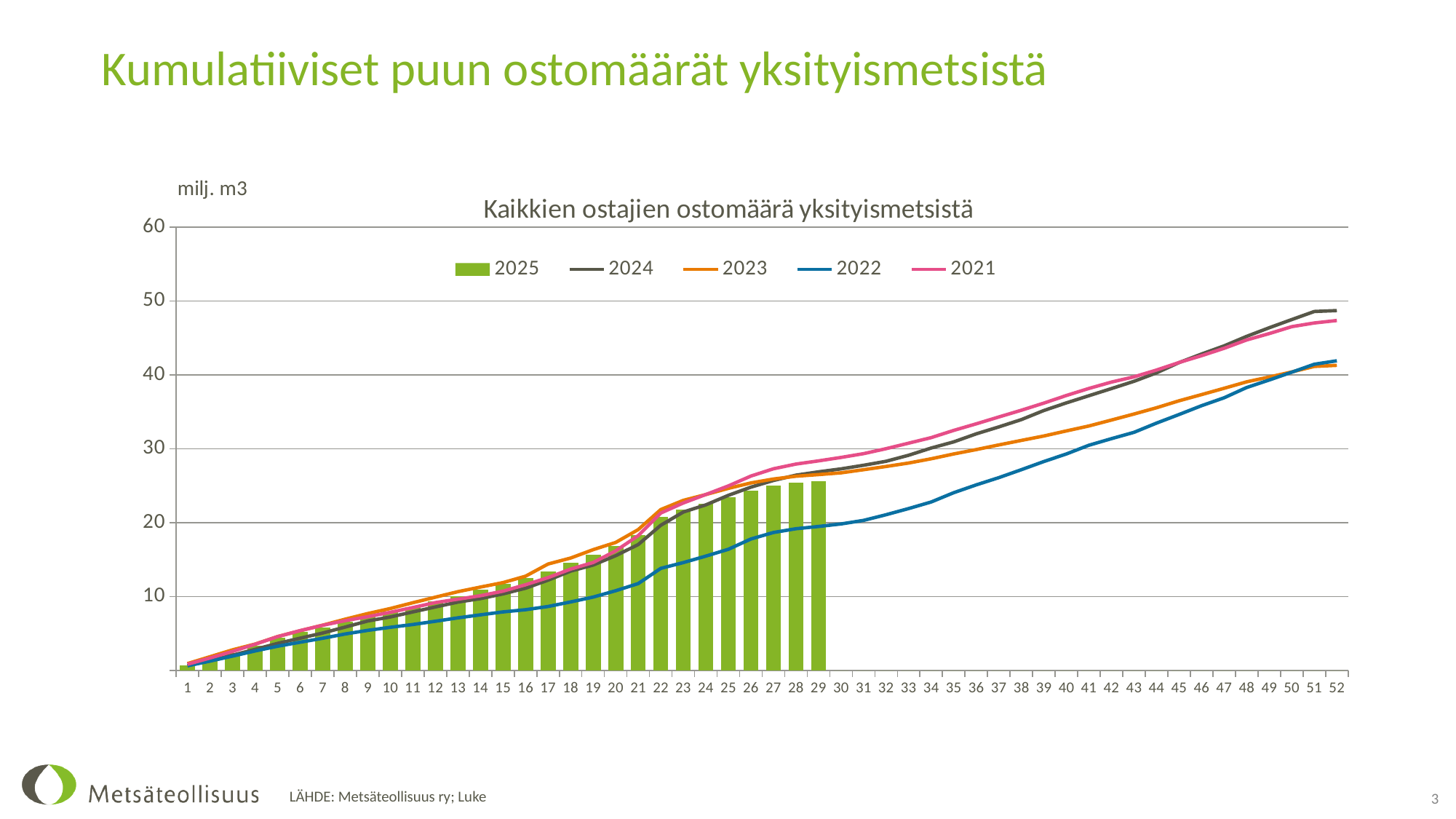
At week 52, is the value for 2024 greater or less than 50? less What kind of chart is shown on the slide? A combined bar and line chart Do the values for the 2024 line rise or fall along the x axis? Rise Which series is drawn as bars rather than a line? 2025 At week 52, which is larger, the value for 2024 or the value for 2022? 2024 What is the title of the chart? Kaikkien ostajien ostomäärä yksityismetsistä How many weeks are labelled on the x axis? 52 How many series does the chart legend list? 5 Which series has the highest value at week 52? 2024 Which series has the lowest value at week 40? 2022 Up to which week are bars plotted for 2025? 29